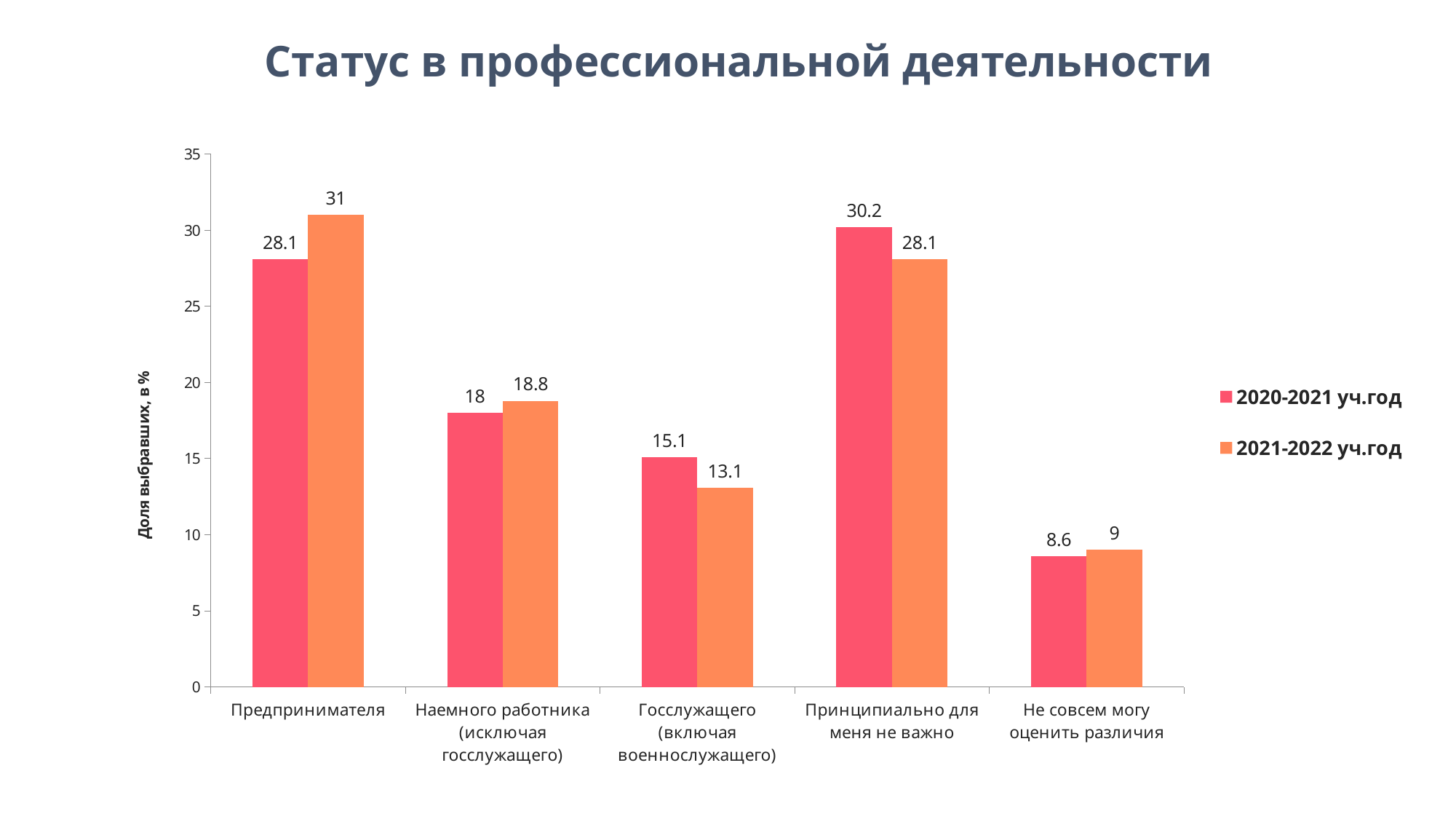
How many categories are shown on the x axis? 5 What type of chart is shown on the slide? bar chart For Госслужащего (включая военнослужащего), which series has the larger value: 2020-2021 уч.год or 2021-2022 уч.год? 2020-2021 уч.год How many series does the legend list? 2 Is the 2020-2021 уч.год value for Наемного работника (исключая госслужащего) greater or less than 20? less What is the difference between the 2020-2021 уч.год and 2021-2022 уч.год values for Принципиально для меня не важно? 2.1 What is the value for Предпринимателя in the 2021-2022 уч.год series? 31 What is the value for Госслужащего (включая военнослужащего) in the 2020-2021 уч.год series? 15.1 Which category has the lowest value in the 2021-2022 уч.год series? Не совсем могу оценить различия What is the value for Не совсем могу оценить различия in the 2021-2022 уч.год series? 9 Which category has the highest value in the 2020-2021 уч.год series? Принципиально для меня не важно What is the difference between the 2021-2022 уч.год and 2020-2021 уч.год values for Предпринимателя? 2.9